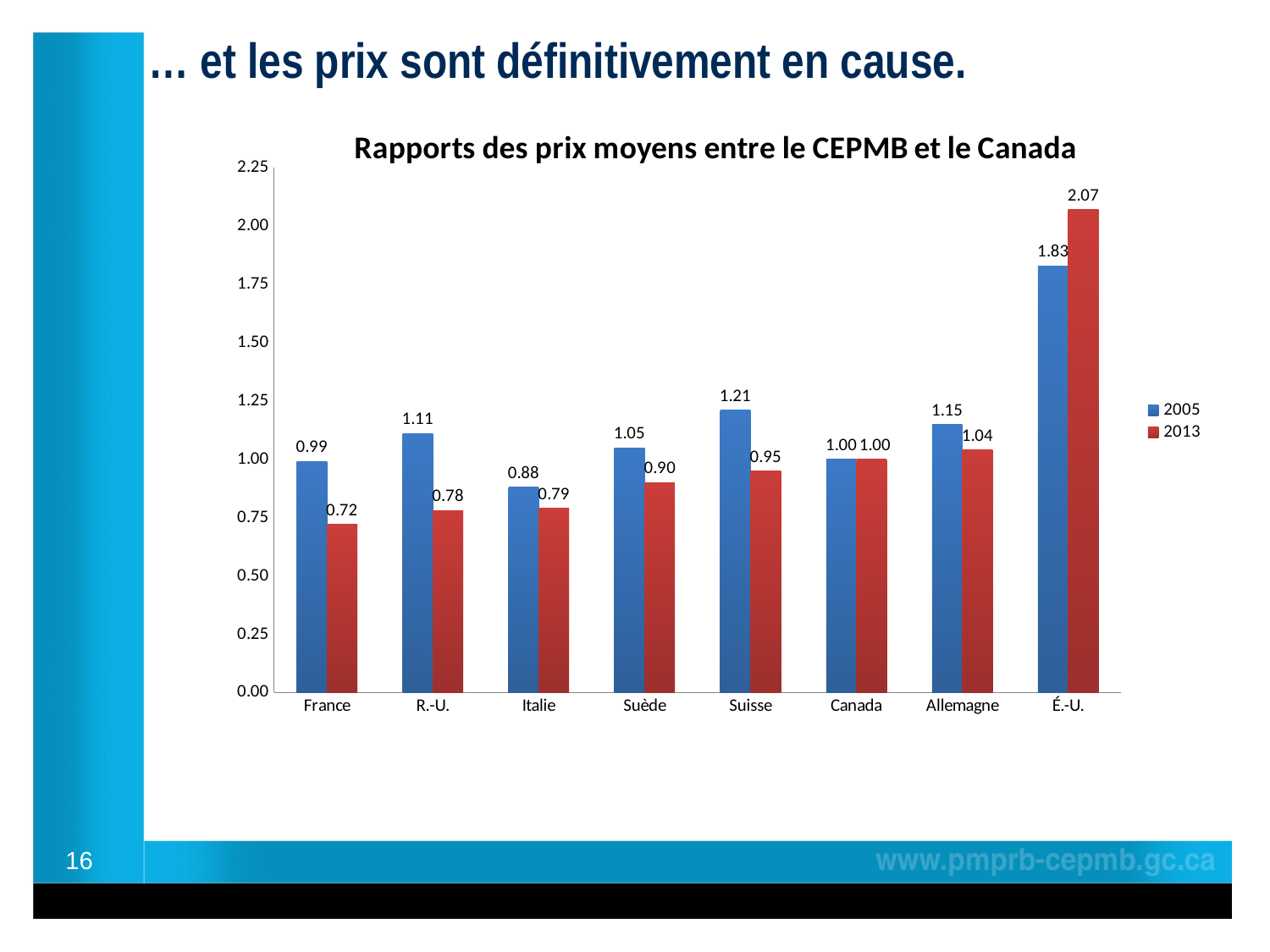
Which country has the lowest 2005 value? Italie What is the 2013 value for France? 0.72 What is the title of the chart? Rapports des prix moyens entre le CEPMB et le Canada What is the difference between the 2013 and 2005 values for É.-U.? 0.24 Is the 2005 value for É.-U. greater or less than 1.75? greater How many countries are shown on the x axis? 8 What is the 2013 value for É.-U.? 2.07 Which country has the highest 2013 value? É.-U. How many series does the legend list? 2 What kind of chart is shown on the slide? Bar chart Which is larger for Allemagne, the 2005 value or the 2013 value? 2005 What is the 2005 value for Suisse? 1.21